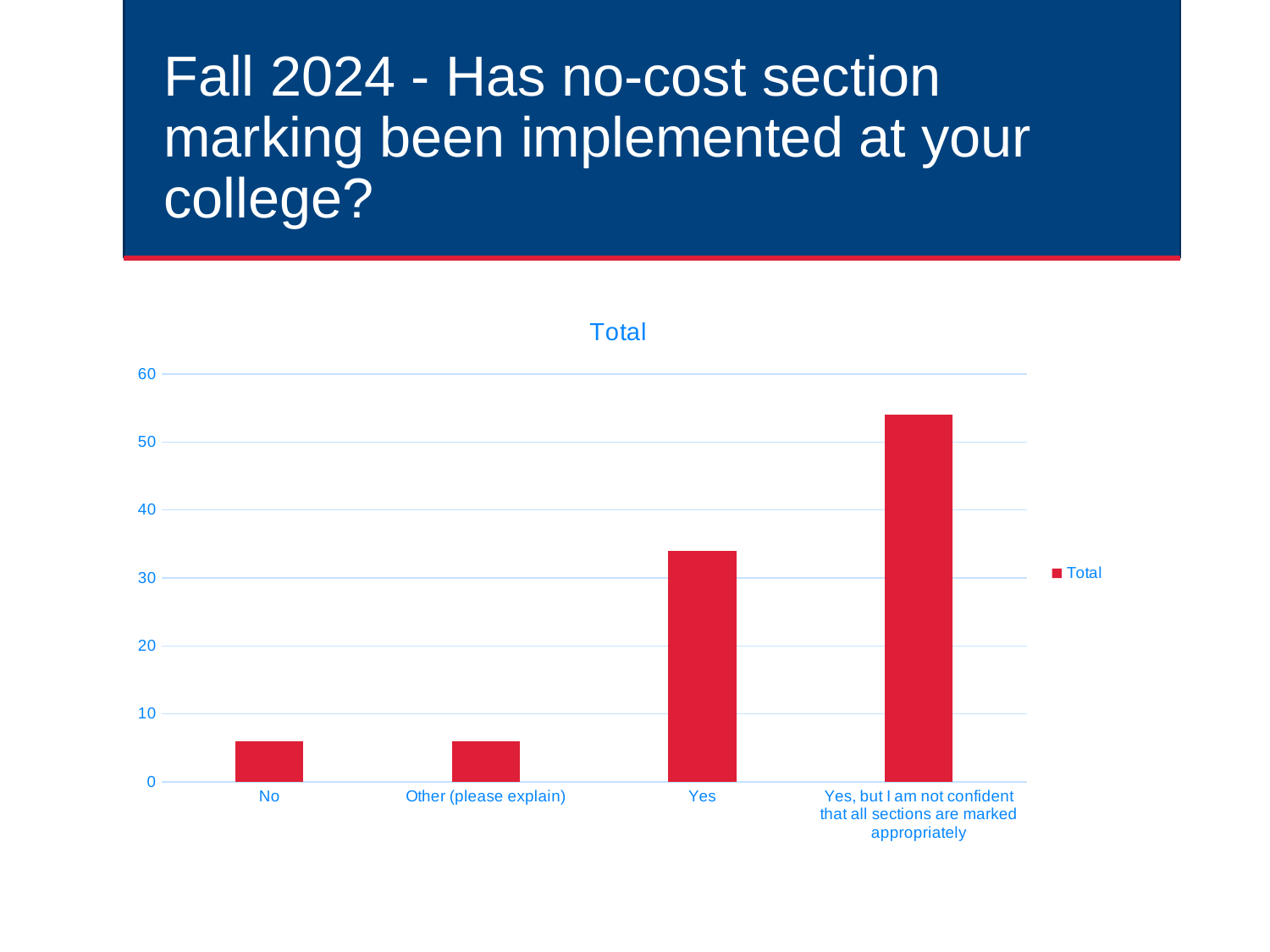
Is the value for "Yes, but I am not confident that all sections are marked appropriately" greater or less than 50? greater Is the value for "Other (please explain)" greater or less than 10? less Which category has the highest value? Yes, but I am not confident that all sections are marked appropriately Is the value for "Yes" greater or less than 40? less Which is larger, the value for "Yes" or the value for "No"? Yes How many categories are shown on the x axis of the chart? 4 What is the title of the chart? Total What kind of chart is shown on the slide? bar chart What is the name of the series shown in the legend? Total How many series does the legend list? 1